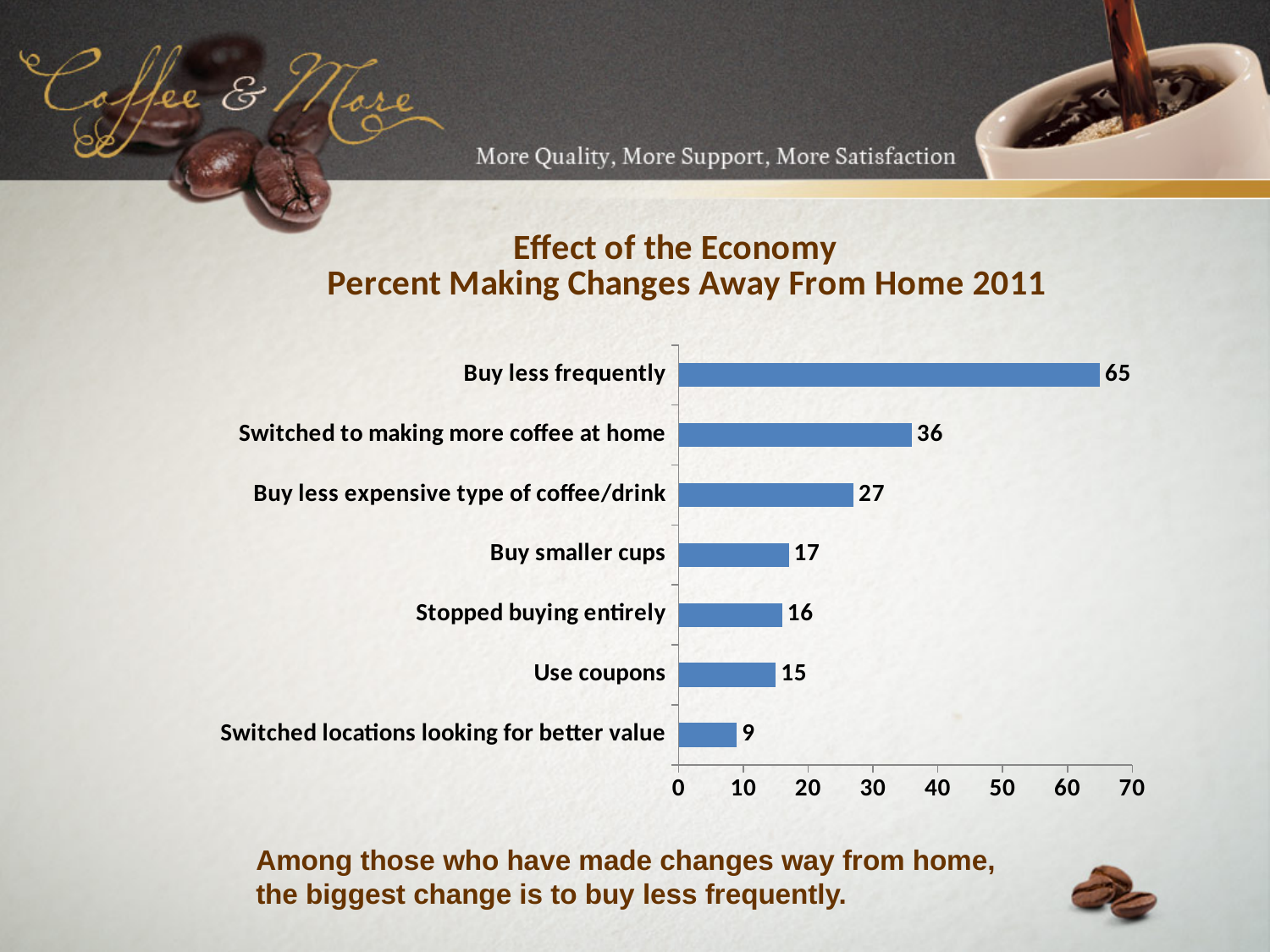
What is the value for "Buy less frequently"? 65 How many categories are shown in the chart? 7 Is the value for "Buy less expensive type of coffee/drink" greater or less than 20? greater Which is larger, the value for "Buy smaller cups" or the value for "Stopped buying entirely"? Buy smaller cups What is the difference between the values for "Buy less frequently" and "Switched to making more coffee at home"? 29 Which category has the highest value? Buy less frequently What is the title of the chart? Effect of the Economy Percent Making Changes Away From Home 2011 What is the value for "Switched to making more coffee at home"? 36 What kind of chart is shown on the slide? Bar chart What is the value for "Use coupons"? 15 What is the difference between the values for "Buy less expensive type of coffee/drink" and "Buy smaller cups"? 10 Which category has the lowest value? Switched locations looking for better value